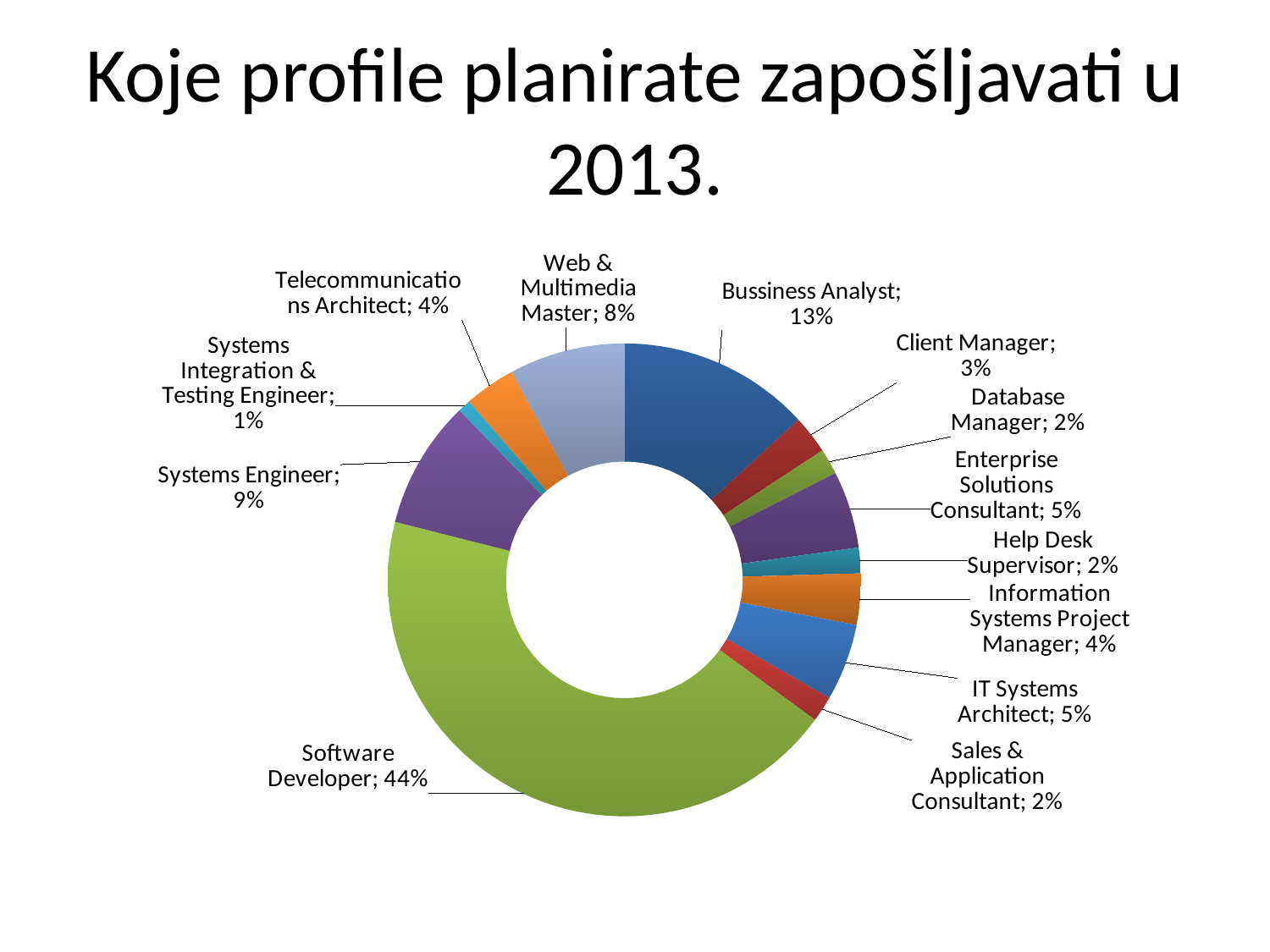
What is the value for Bussiness Analyst? 13% What kind of chart is shown on the slide? doughnut chart Which is larger, the share for Systems Engineer or the share for Web & Multimedia Master? Systems Engineer What is the value for Systems Integration & Testing Engineer? 1% What is the difference between the shares of Software Developer and Bussiness Analyst? 31% How many categories are shown in the chart? 13 What is the title of the slide? Koje profile planirate zapošljavati u 2013. Which category has the smallest share? Systems Integration & Testing Engineer What is the value for Systems Engineer? 9% Which category has the largest share? Software Developer What is the value for Web & Multimedia Master? 8% What share does Software Developer have? 44%